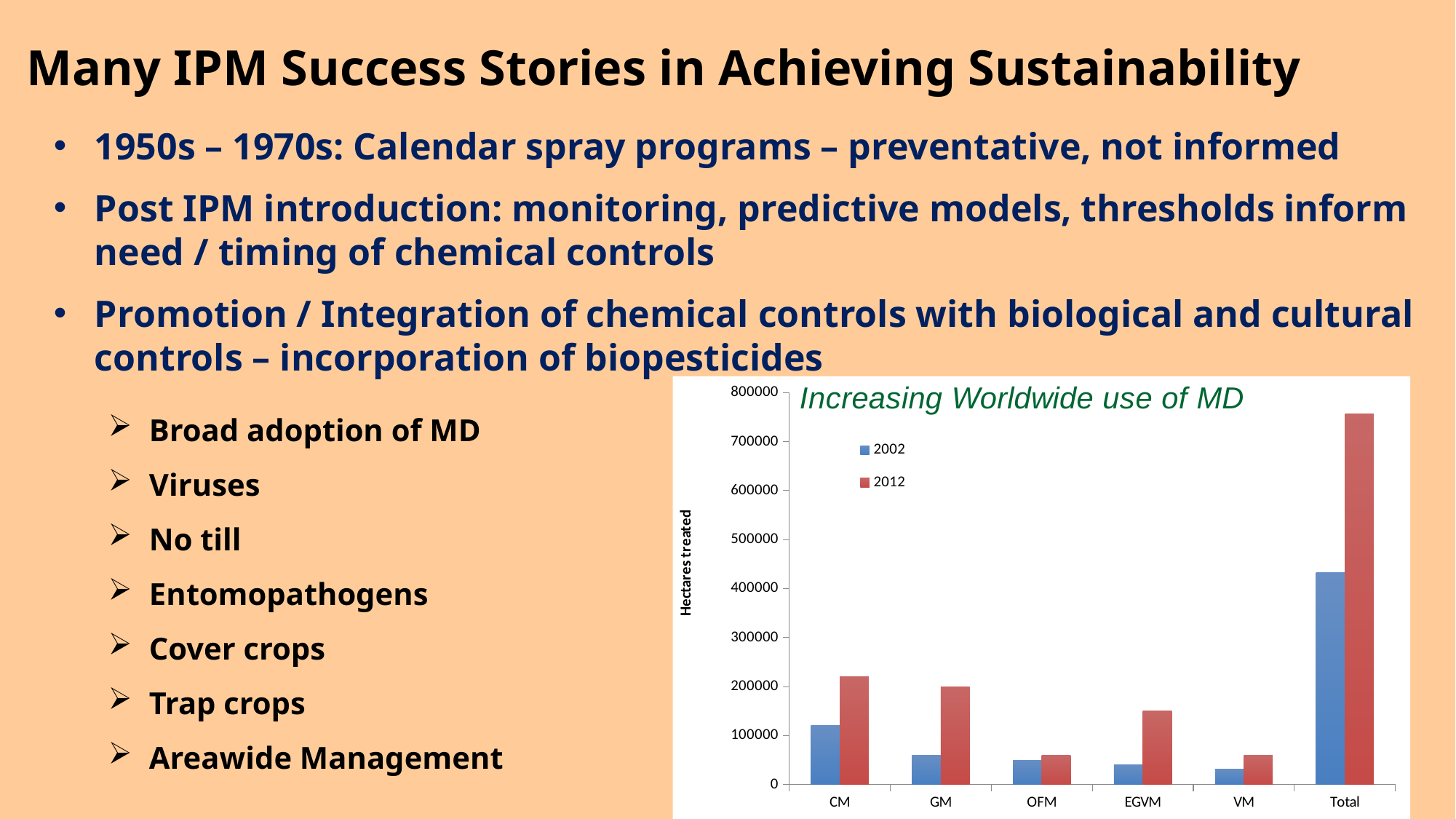
What kind of chart is shown on the slide? bar chart How many series does the chart legend list? 2 Is the 2012 value for EGVM greater or less than 100000? greater Which has the larger 2012 value, EGVM or OFM? EGVM What is the title of the chart? Increasing Worldwide use of MD How many categories are shown on the x axis of the chart? 6 What is the label on the vertical axis of the chart? Hectares treated Is the 2002 value for GM greater or less than 100000? less Which category has the highest 2012 value? Total Which has the larger 2012 value, CM or GM? CM Is the 2012 value for CM greater or less than 200000? greater